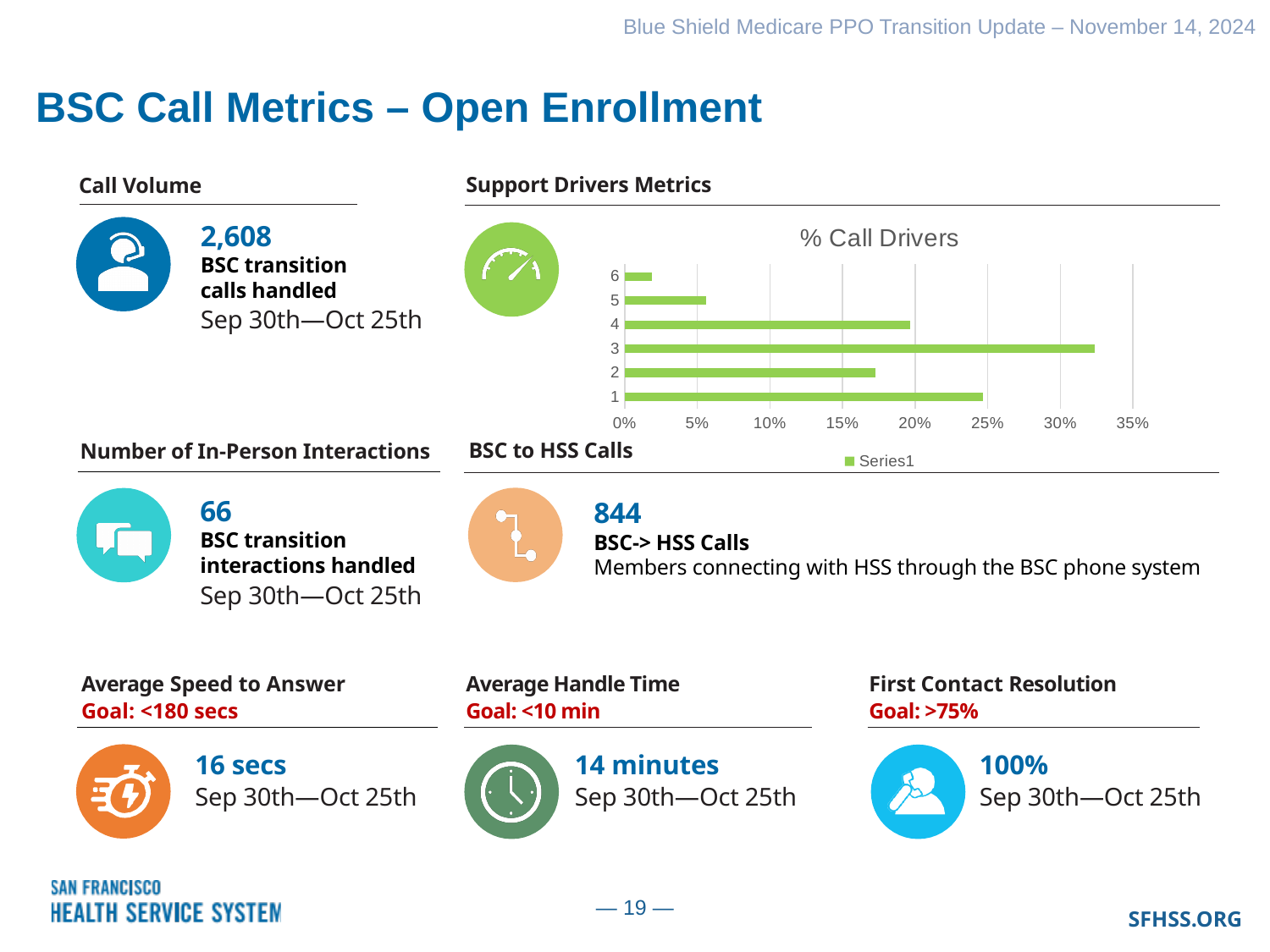
In the '% Call Drivers' chart, is the value for category 3 greater or less than 30%? greater In the '% Call Drivers' chart, is the value for category 2 greater or less than 15%? greater In the '% Call Drivers' chart, which has the larger value, category 4 or category 5? 4 Which category has the lowest value in the '% Call Drivers' chart? 6 What is the legend entry shown below the '% Call Drivers' chart? Series1 How many categories are plotted in the '% Call Drivers' chart? 6 In the '% Call Drivers' chart, which has the larger value, category 1 or category 2? 1 In the '% Call Drivers' chart, is the value for category 5 greater or less than 10%? less Which category has the highest value in the '% Call Drivers' chart? 3 How many series does the legend of the '% Call Drivers' chart list? 1 What kind of chart is the '% Call Drivers' chart? bar chart